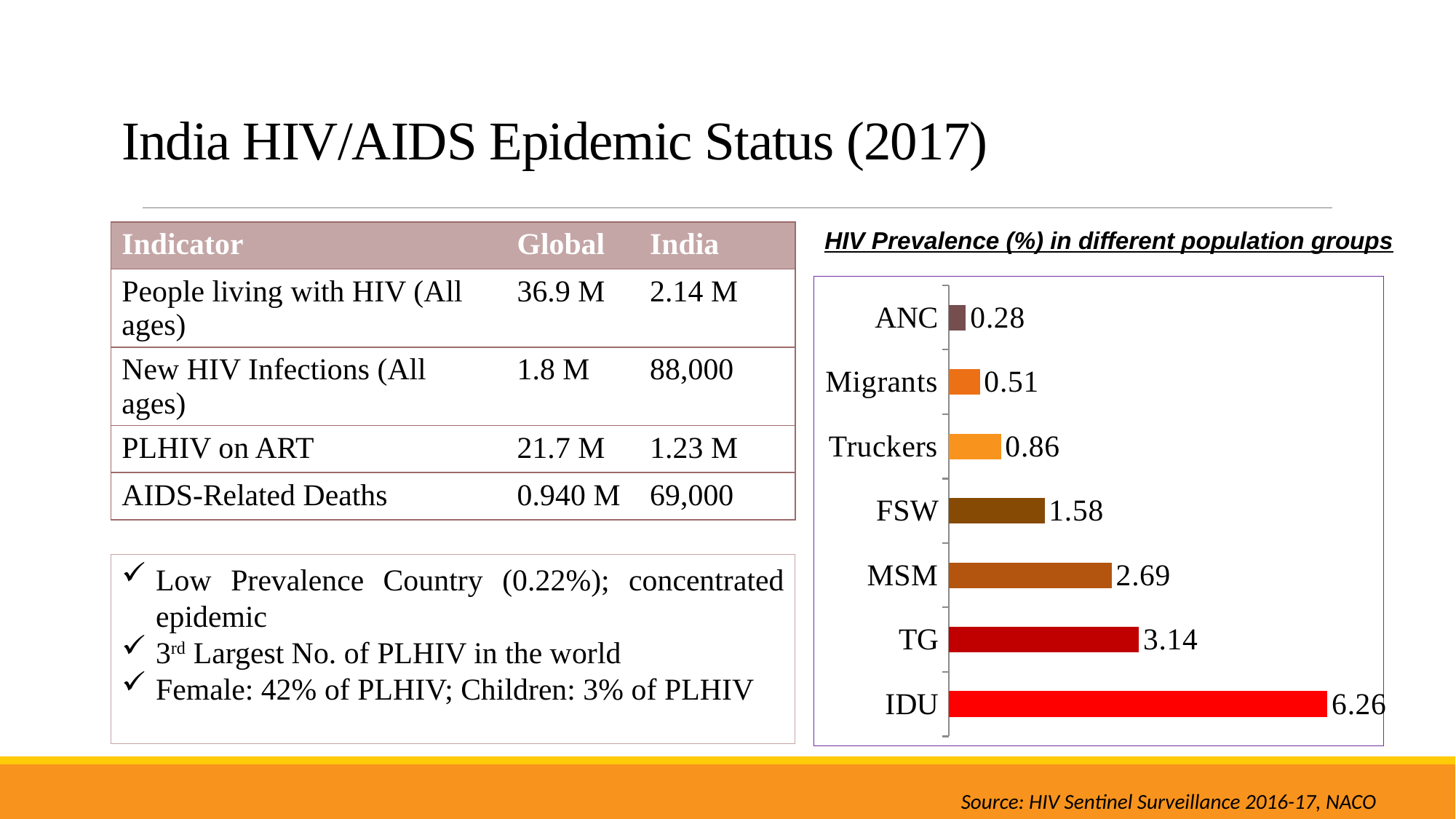
Which has a higher HIV prevalence value, Truckers or Migrants? Truckers Which has a higher HIV prevalence value, TG or MSM? TG What is the HIV prevalence value shown for FSW? 1.58 What is the HIV prevalence value shown for IDU? 6.26 What is the difference between the HIV prevalence values for IDU and TG? 3.12 What is the difference between the HIV prevalence values for MSM and FSW? 1.11 What is the HIV prevalence value shown for Migrants? 0.51 Which population group has the lowest HIV prevalence in the chart? ANC How many population groups are shown in the chart? 7 What kind of chart is used to show HIV prevalence in different population groups? Bar chart What is the title of the chart on the slide? HIV Prevalence (%) in different population groups Which population group has the highest HIV prevalence in the chart? IDU